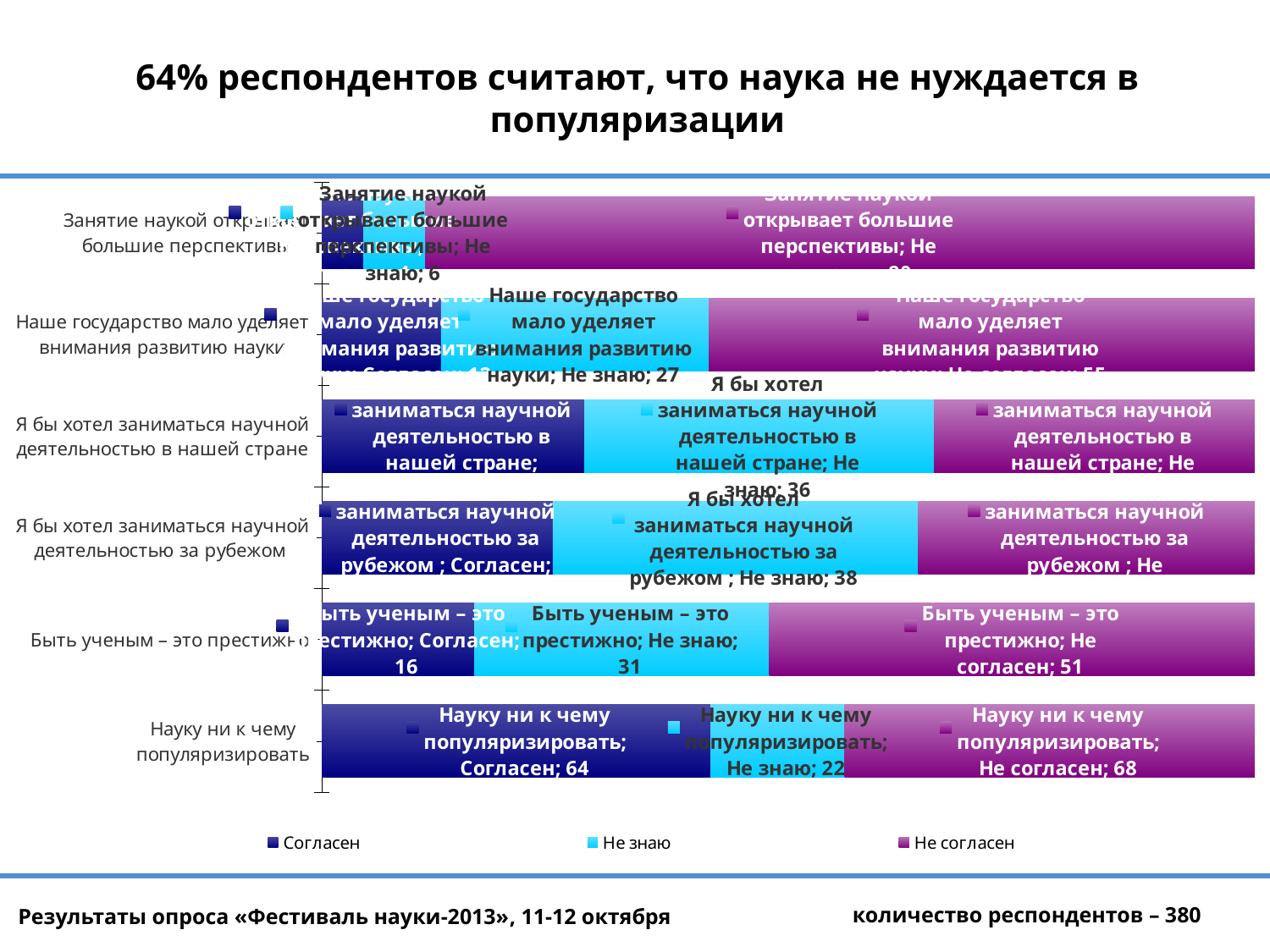
How many series does the legend list? 3 For the statement «Быть ученым – это престижно», what is the difference between the «Не согласен» value and the «Согласен» value? 35 What is the value for «Не согласен» for the statement «Быть ученым – это престижно»? 51 How many statements (categories) are plotted on the chart? 6 What is the value for «Не знаю» for the statement «Я бы хотел заниматься научной деятельностью за рубежом»? 38 What is the value for «Не знаю» for the statement «Я бы хотел заниматься научной деятельностью в нашей стране»? 36 What kind of chart is shown on the slide? Stacked bar chart What is the value for «Не согласен» for the statement «Науку ни к чему популяризировать»? 68 What is the value for «Согласен» for the statement «Быть ученым – это престижно»? 16 What is the value for «Согласен» for the statement «Науку ни к чему популяризировать»? 64 Which statement has the larger «Не знаю» value: «Быть ученым – это престижно» or «Науку ни к чему популяризировать»? Быть ученым – это престижно What is the value for «Не знаю» for the statement «Науку ни к чему популяризировать»? 22